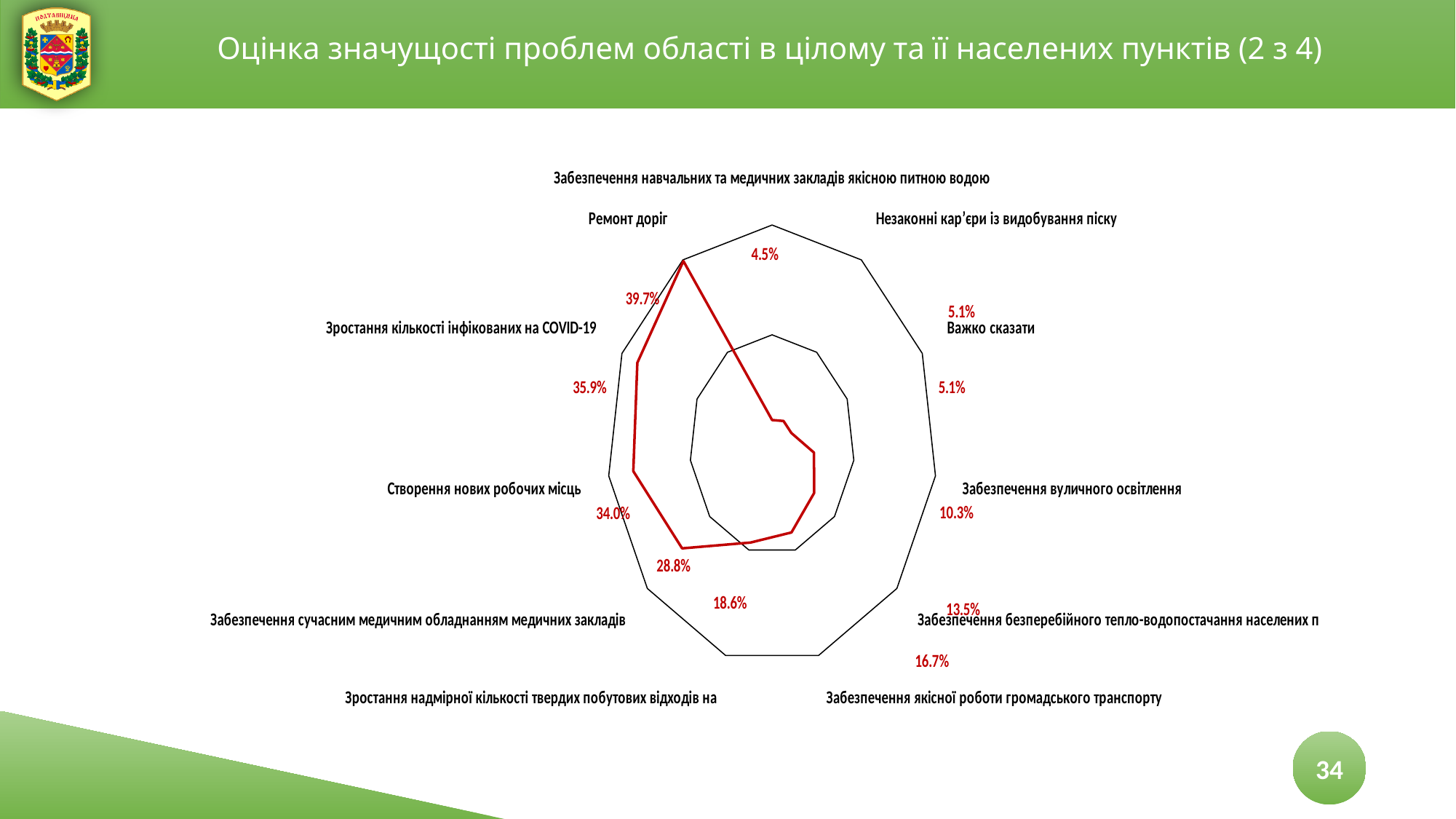
Which category has the highest value? Ремонт доріг How many categories are plotted on the radar chart? 11 What is the value for Забезпечення вуличного освітлення? 10.3% What is the value for Забезпечення якісної роботи громадського транспорту? 16.7% What kind of chart is shown on the slide? Radar chart What colour is the data line on the radar chart? Red Which category has the lowest value? Забезпечення навчальних та медичних закладів якісною питною водою Which is larger: the value for Створення нових робочих місць or for Забезпечення сучасним медичним обладнанням медичних закладів? Створення нових робочих місць What is the value for Створення нових робочих місць? 34.0% What is the difference between the values for Ремонт доріг and Зростання кількості інфікованих на COVID-19? 3.8 percentage points What is the value for Зростання кількості інфікованих на COVID-19? 35.9% What is the value for Ремонт доріг? 39.7%